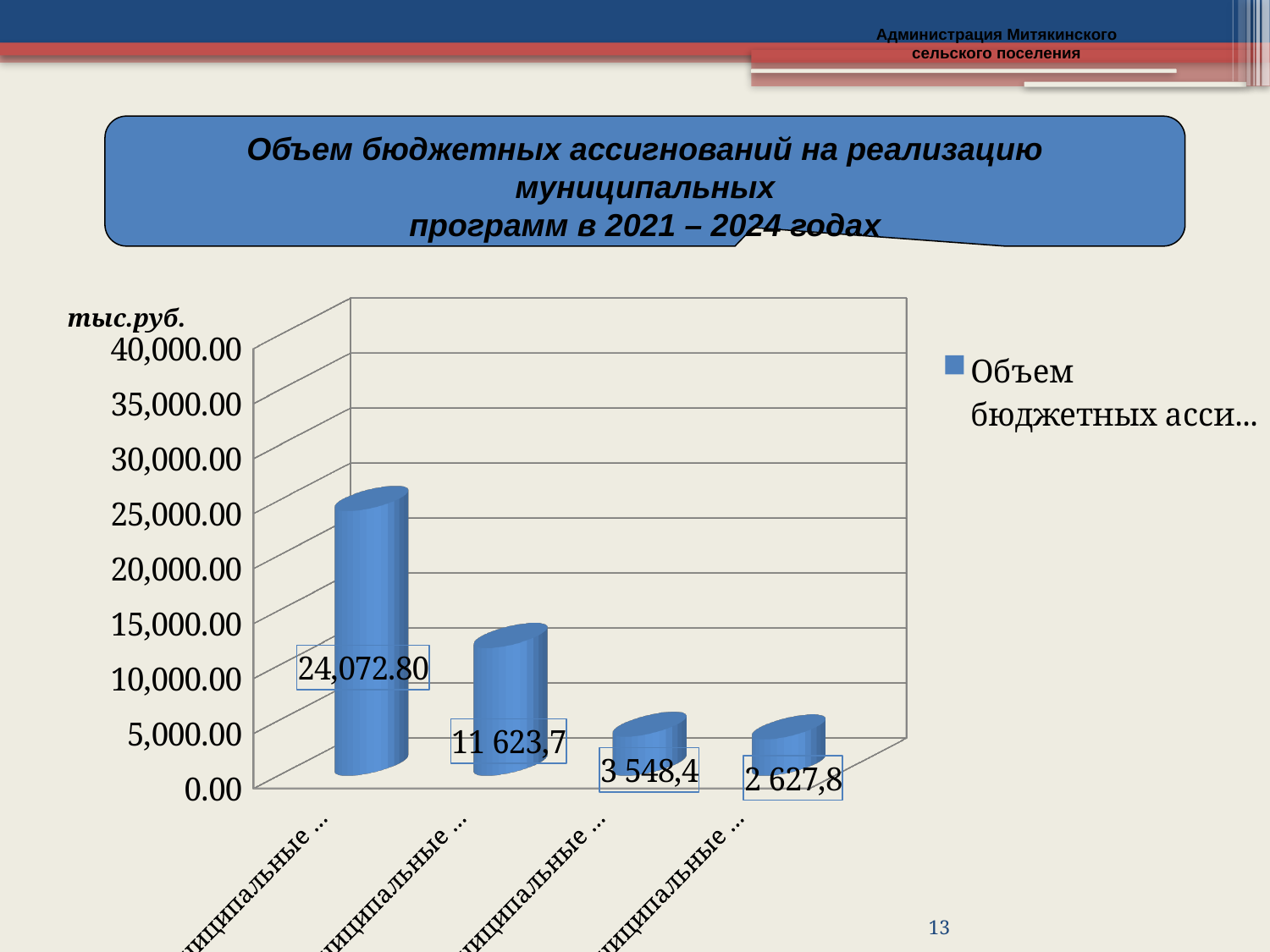
What is the value shown on the second bar from the left? 11 623,7 What kind of chart is shown on the slide? bar chart Is the value for the first bar greater or less than 20,000.00? greater What is the difference between the third bar (3 548,4) and the fourth bar (2 627,8)? 920,6 Which is larger, the value of the second bar or the value of the third bar? the second bar Do the bar values rise or fall from left to right? fall Which bar has the highest value? the first (leftmost) bar What is the value shown on the third bar from the left? 3 548,4 What is the value shown on the fourth (rightmost) bar? 2 627,8 What is the value shown on the first (leftmost) bar? 24,072.80 How many bars are plotted in the chart? 4 Which bar has the lowest value? the fourth (rightmost) bar